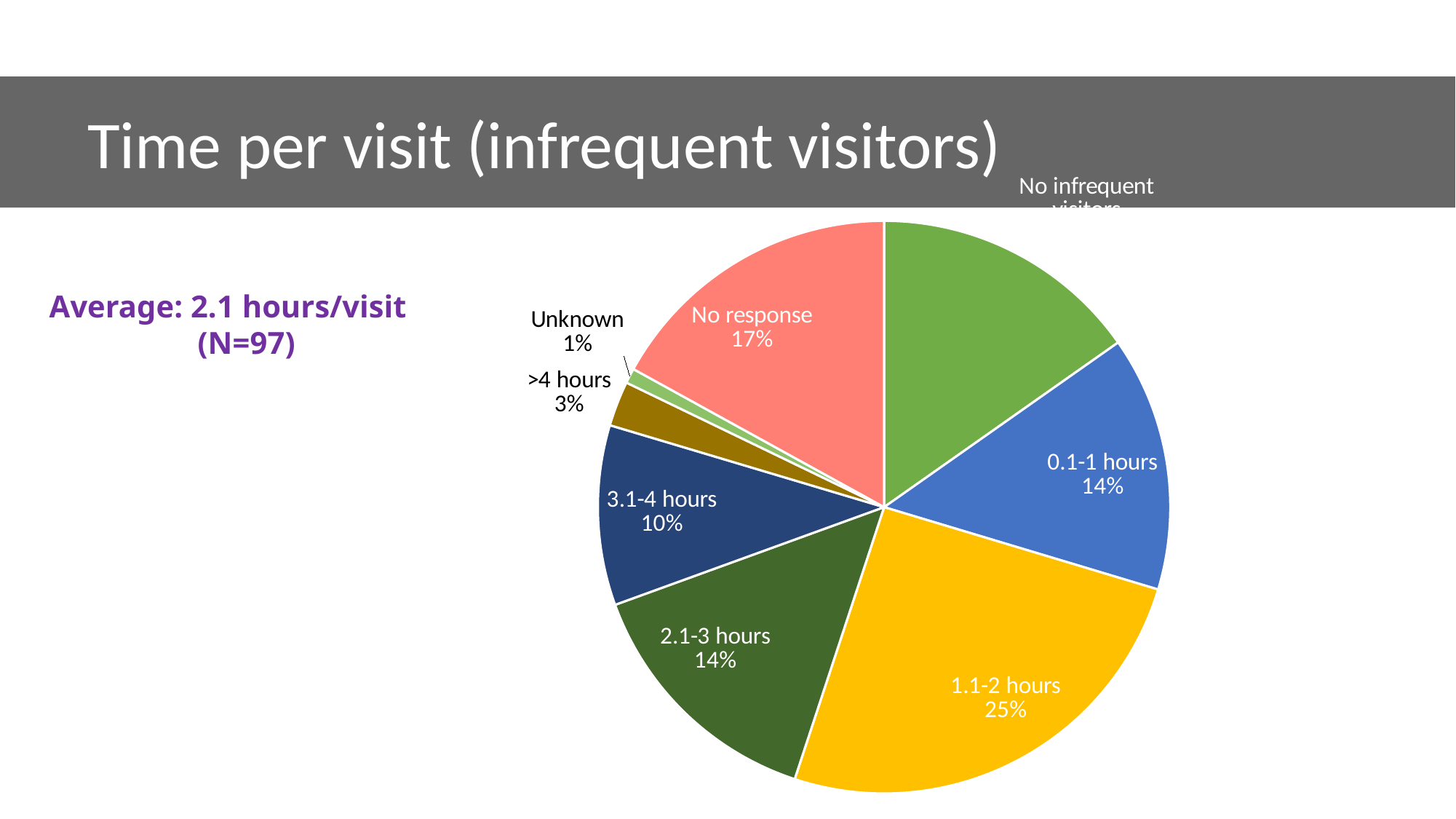
What is the value for the 0.1-1 hours slice? 14% What kind of chart is shown on the slide? pie chart What is the value for the No response slice? 17% How many slices does the pie chart have? 8 What is the title of the slide containing the pie chart? Time per visit (infrequent visitors) What is the difference in percentage points between the 1.1-2 hours slice and the 2.1-3 hours slice? 11 Which slice has the smallest share of the pie? Unknown What is the value for the >4 hours slice? 3% Which labelled slice has the largest share of the pie? 1.1-2 hours Which is larger, the No response slice or the 3.1-4 hours slice? No response What share of the pie is the 1.1-2 hours slice? 25% What is the value for the 3.1-4 hours slice? 10%